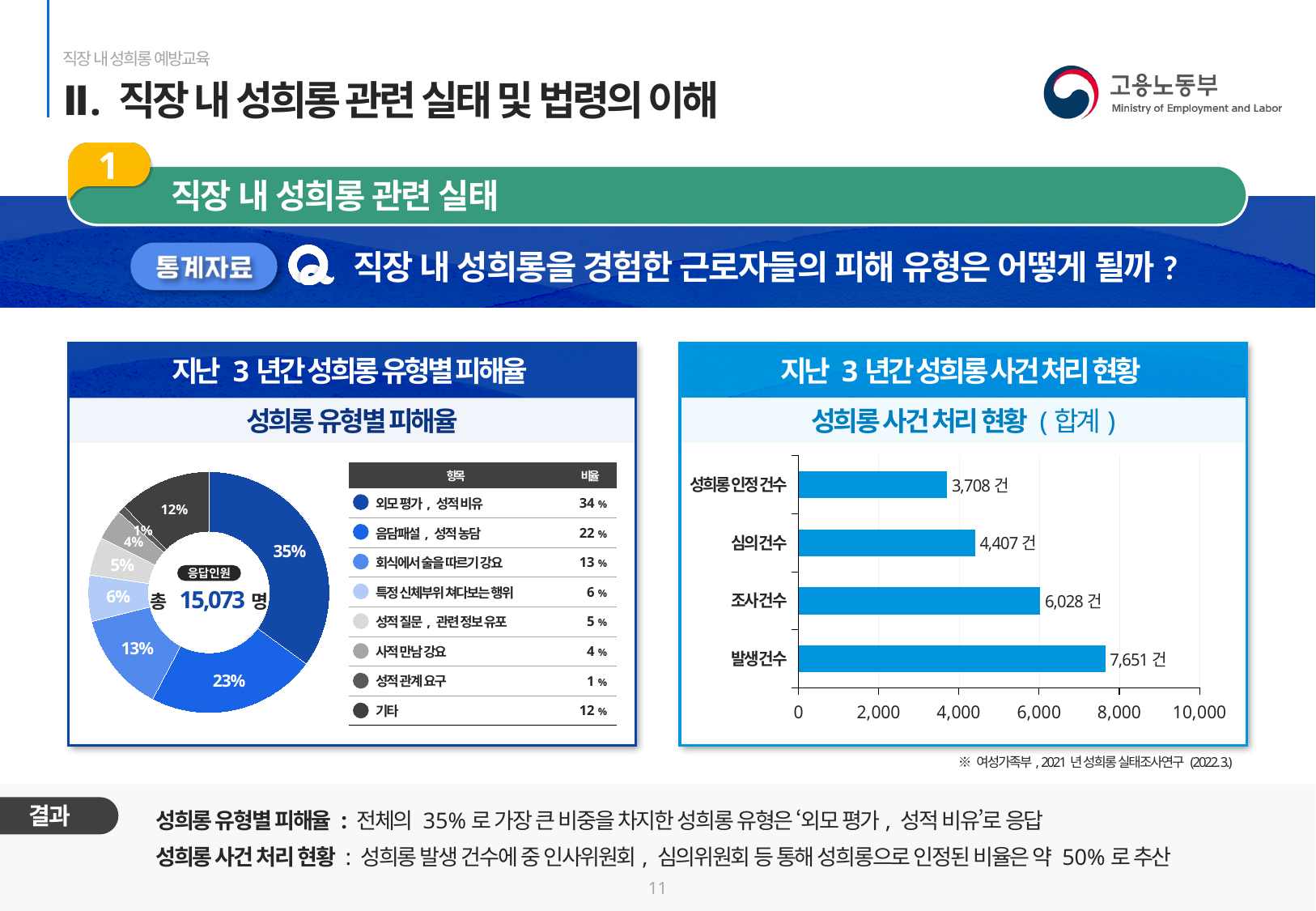
In the bar chart titled 성희롱 사건 처리 현황 (합계), which category has the lowest value? 성희롱 인정 건수 In the chart titled 성희롱 유형별 피해율, which is larger: 회식에서 술을 따르기 강요 or 사적 만남 강요? 회식에서 술을 따르기 강요 In the chart titled 성희롱 유형별 피해율, which type has the largest share? 외모 평가, 성적 비유 In the bar chart titled 성희롱 사건 처리 현황 (합계), how many categories are shown? 4 In the bar chart titled 성희롱 사건 처리 현황 (합계), what is the value for 성희롱 인정 건수? 3,708 건 In the bar chart titled 성희롱 사건 처리 현황 (합계), which category has the highest value? 발생건수 In the bar chart titled 성희롱 사건 처리 현황 (합계), what is the difference between 조사건수 and 심의건수? 1,621 건 What kind of chart is the chart titled 성희롱 사건 처리 현황 (합계)? bar chart In the bar chart titled 성희롱 사건 처리 현황 (합계), what is the value for 발생건수? 7,651 건 In the bar chart titled 성희롱 사건 처리 현황 (합계), is the value for 조사건수 greater or less than 6,000? greater In the chart titled 성희롱 유형별 피해율, what is the total number of respondents (응답인원) shown in the centre of the donut? 15,073 명